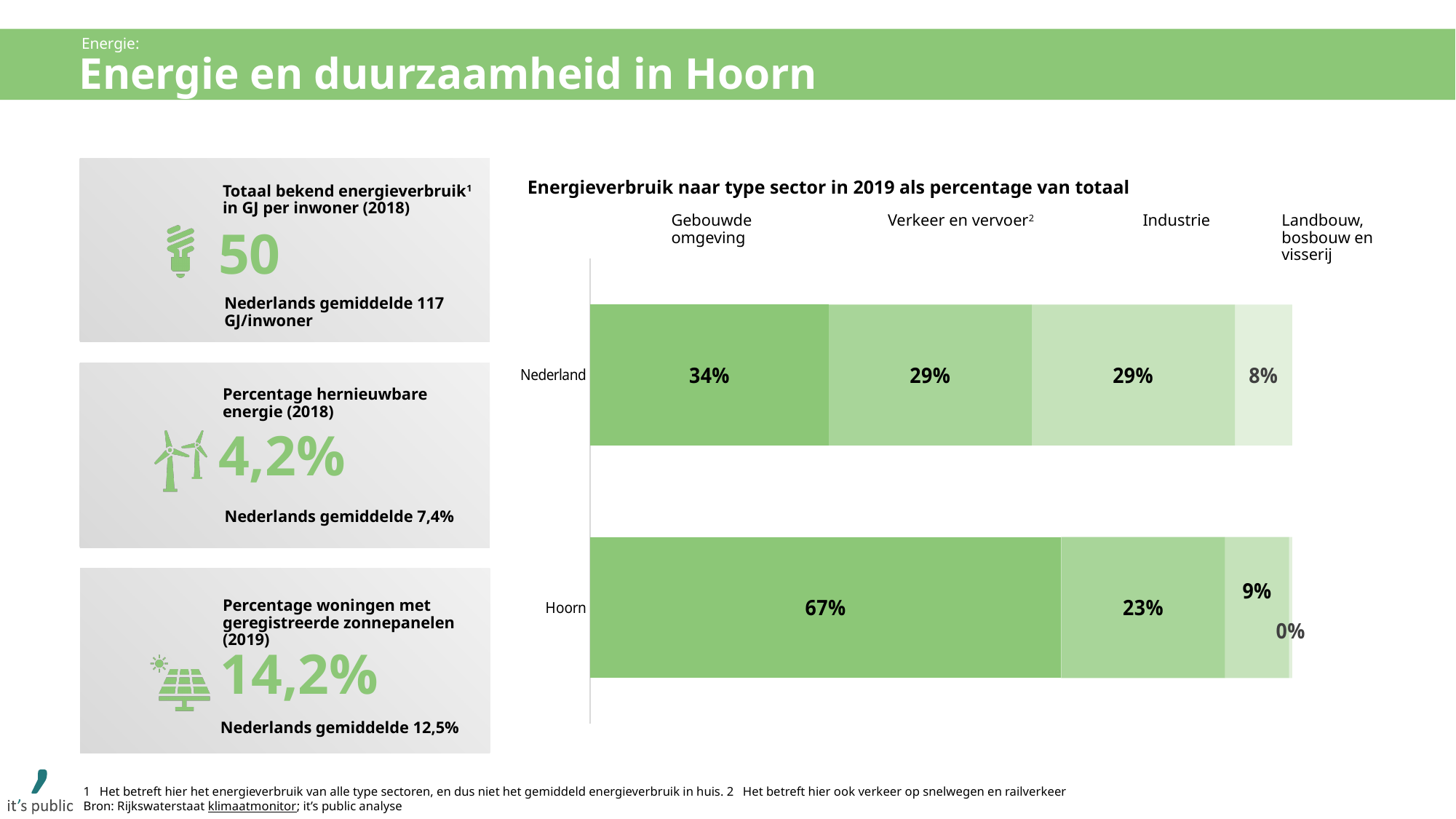
How many sectors (series) are shown in the stacked bar chart? 4 How many bars (regions) are shown in the chart? 2 Which has a larger Industrie share, Nederland or Hoorn? Nederland What is the value for Verkeer en vervoer in Hoorn? 23% What is the difference between the Gebouwde omgeving share for Hoorn and for Nederland? 33 percentage points What is the value for Landbouw, bosbouw en visserij in Hoorn? 0% Which sector has the smallest share of energy consumption in Nederland? Landbouw, bosbouw en visserij Which sector has the largest share of energy consumption in Hoorn? Gebouwde omgeving What type of chart is used to show energy consumption by sector? Stacked bar chart What is the value for Industrie in Nederland? 29% What percentage of energy consumption in Hoorn comes from Gebouwde omgeving? 67% What percentage of energy consumption in Nederland comes from Gebouwde omgeving? 34%